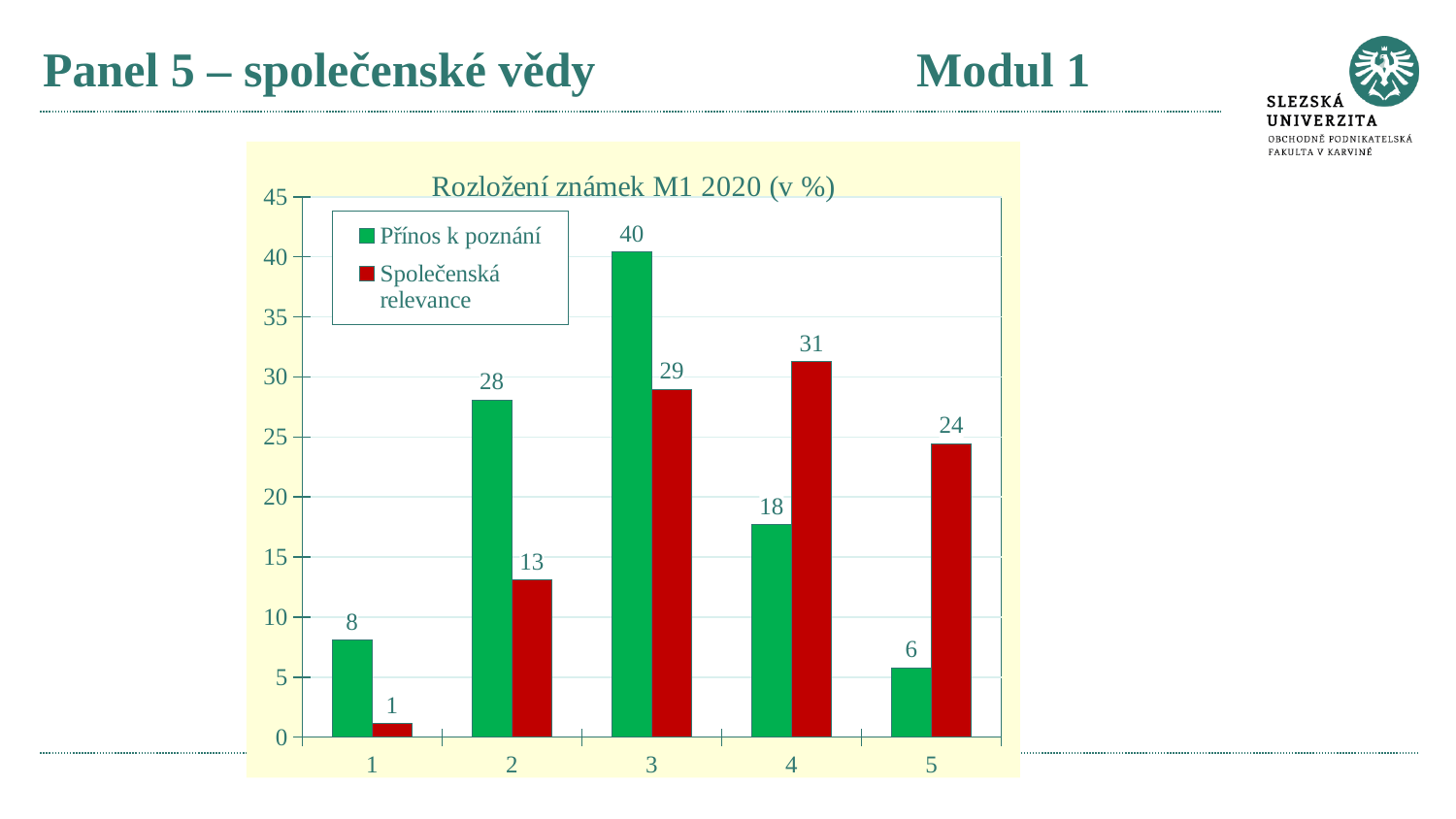
Which category has the lowest value for Společenská relevance? 1 What is the value for Společenská relevance at category 1? 1 What is the value for Přínos k poznání at category 3? 40 How many categories are shown on the x axis? 5 What is the value for Přínos k poznání at category 5? 6 What is the value for Společenská relevance at category 4? 31 What kind of chart is shown? bar chart At category 5, which series has the larger value, Přínos k poznání or Společenská relevance? Společenská relevance How many series does the legend list? 2 What is the title of the chart? Rozložení známek M1 2020 (v %) Which category has the highest value for Přínos k poznání? 3 What is the difference between Přínos k poznání and Společenská relevance at category 2? 15